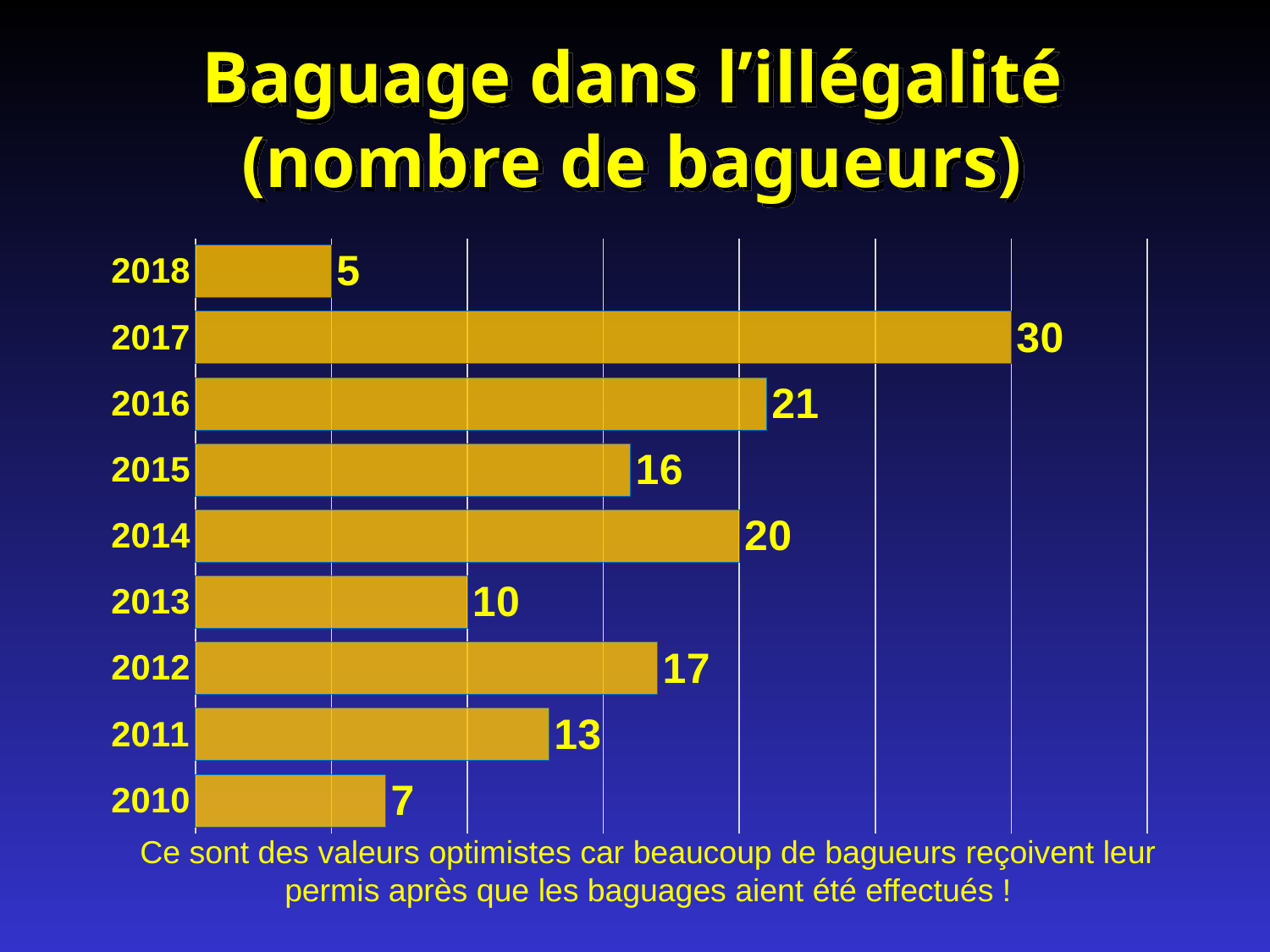
Which year has the lowest value? 2018 What kind of chart is shown on the slide? bar chart How many years are shown in the chart? 9 Which is larger, the value for 2011 or the value for 2014? 2014 What is the difference between the values for 2017 and 2016? 9 What is the value for 2013? 10 What is the value for 2010? 7 What is the title of the chart? Baguage dans l'illégalité (nombre de bagueurs) What is the value for 2017? 30 What is the difference between the values for 2014 and 2013? 10 Which is larger, the value for 2012 or the value for 2015? 2012 Which year has the highest value? 2017